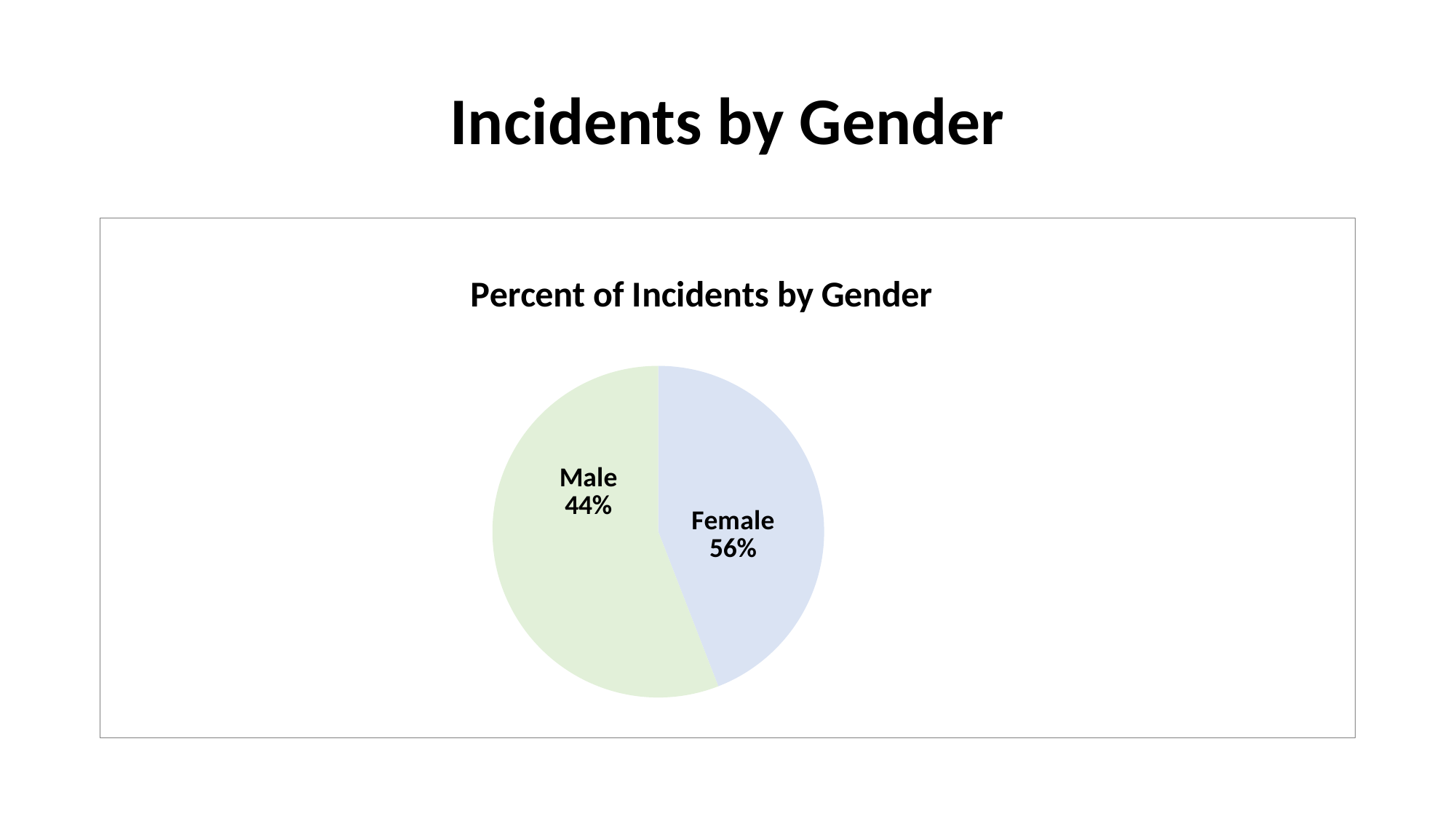
What is the title of the chart? Percent of Incidents by Gender What percentage of incidents is attributed to Female? 56% What percentage of incidents is attributed to Male? 44% Which gender has the smaller share of incidents? Male What is the difference in percentage points between the Female and Male shares? 12 Which gender has the larger share of incidents? Female How many slices does the pie chart have? 2 What share of the pie does the Male slice represent? 44% Is the Female share larger or smaller than the Male share? larger What kind of chart is shown on the slide? pie chart Which colour is used for the Female slice? light blue